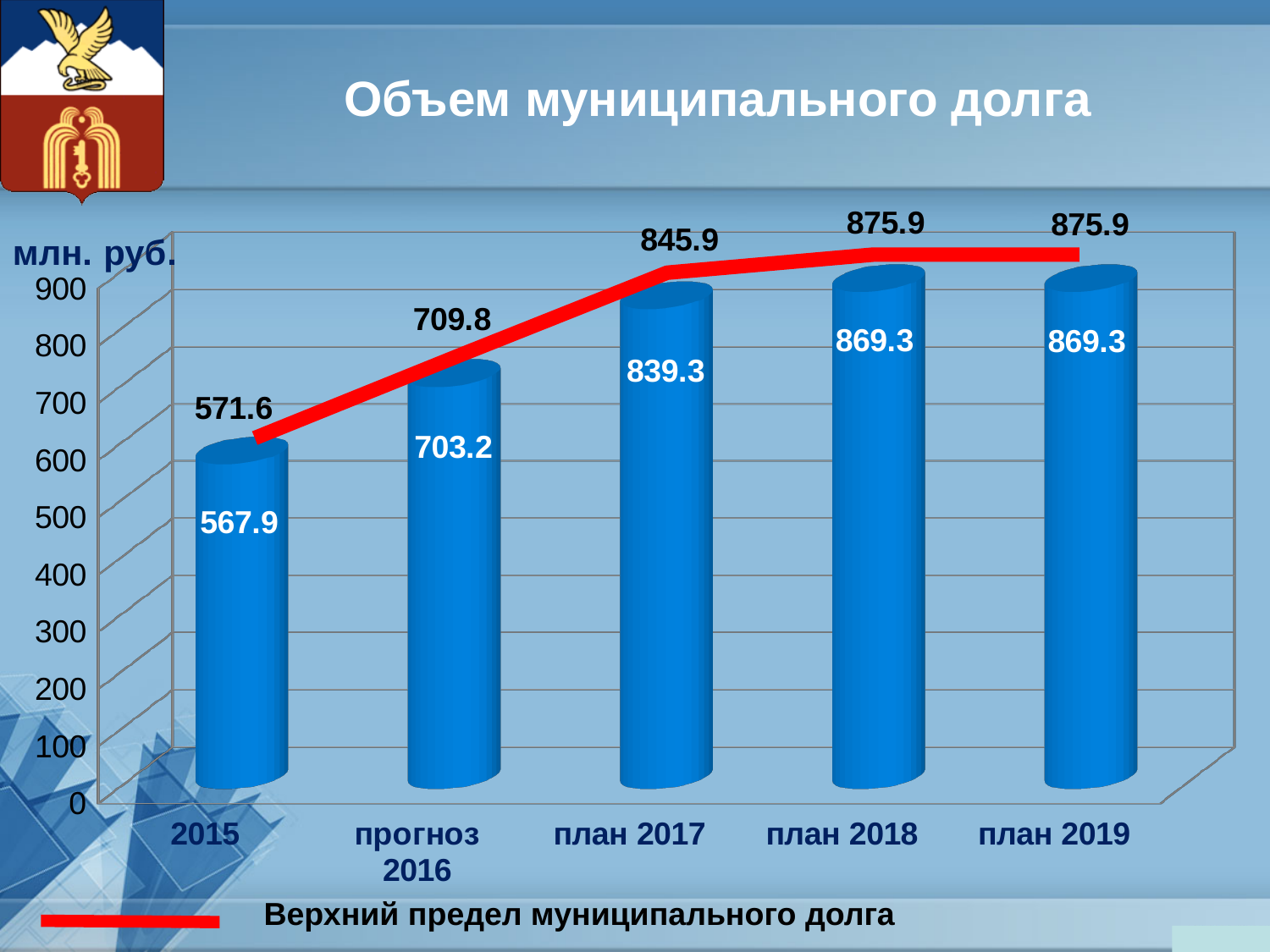
Which category has the lowest bar value? 2015 What unit is shown on the vertical axis of the chart? млн. руб. What is the title of the chart? Объем муниципального долга What is the value of the red line (Верхний предел муниципального долга) for прогноз 2016? 709.8 What is the value of the bar for план 2017? 839.3 Which is larger, the bar value for прогноз 2016 or the bar value for 2015? прогноз 2016 What is the difference between the red line value and the bar value for план 2019? 6.6 What is the difference between the bar values for план 2017 and прогноз 2016? 136.1 What is the value of the bar for 2015? 567.9 What is the value of the red line (Верхний предел муниципального долга) for план 2018? 875.9 How many categories are shown on the x axis? 5 Do the bar values rise or fall from 2015 to план 2018? rise